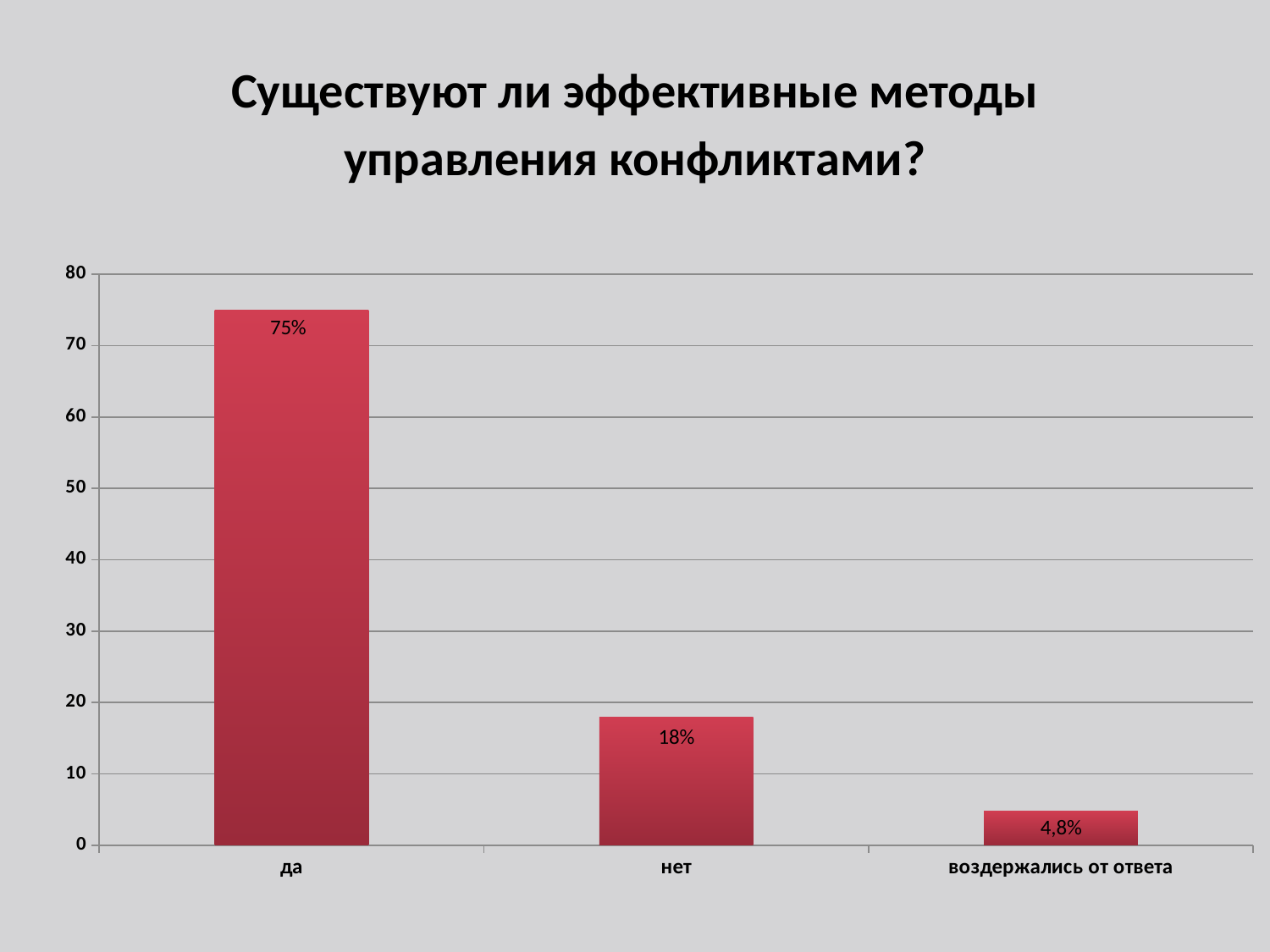
What is the value for "нет"? 18% What is the difference between the values for "да" and "нет"? 57% Which is larger, the value for "нет" or the value for "воздержались от ответа"? нет Which category has the lowest value? воздержались от ответа Which category has the highest value? да How many categories are shown on the x axis? 3 Is the value for "да" greater or less than 70? greater What is the title of the chart? Существуют ли эффективные методы управления конфликтами? What is the value for "да"? 75% Is the value for "нет" greater or less than 20? less What is the value for "воздержались от ответа"? 4,8% What kind of chart is shown on the slide? bar chart